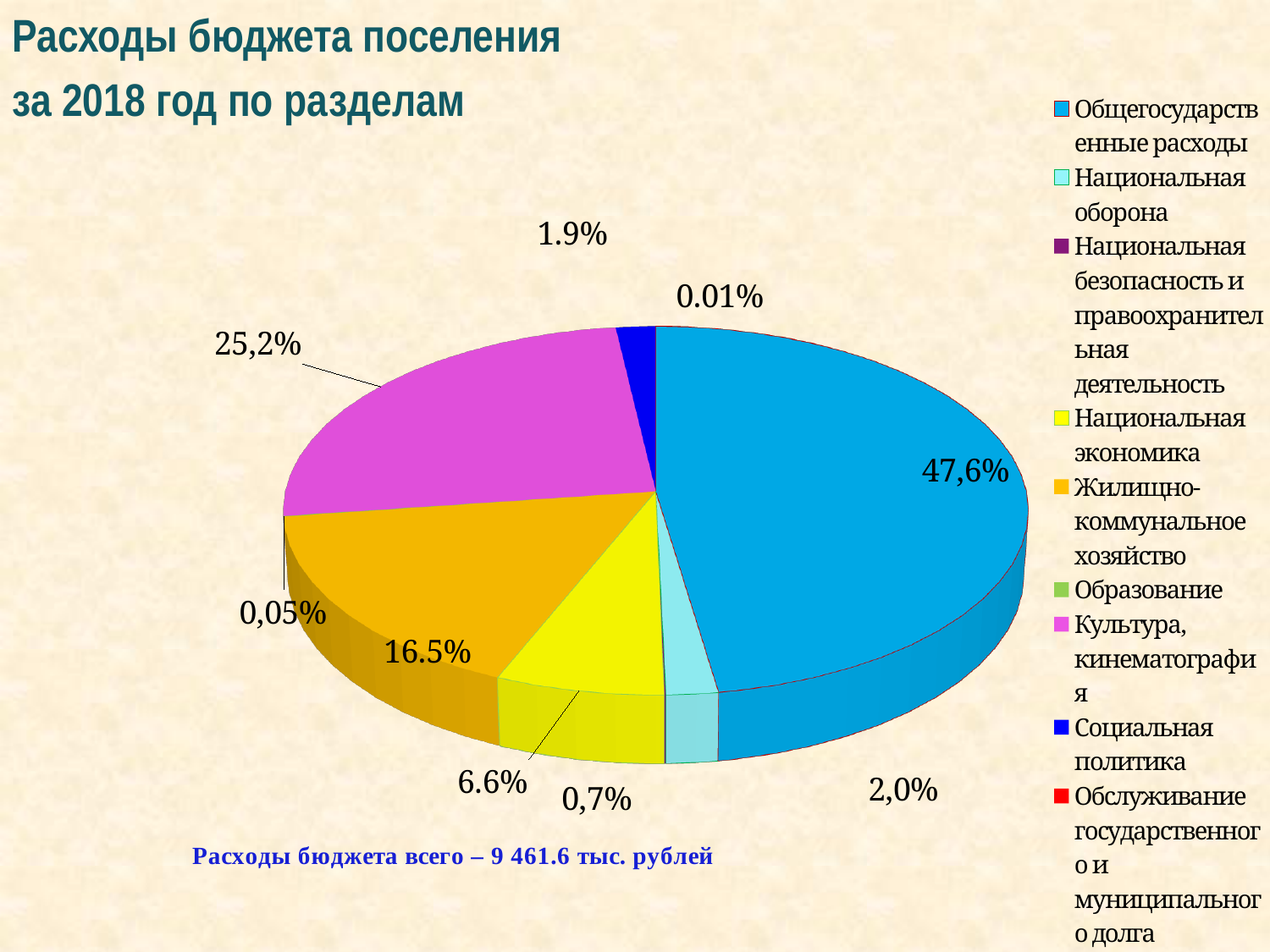
What is the difference between the share for Общегосударственные расходы and the share for Культура, кинематография? 22,4% Which is larger: the share for Культура, кинематография or the share for Жилищно-коммунальное хозяйство? Культура, кинематография What share of the pie is labelled for Общегосударственные расходы? 47,6% What kind of chart is shown on the slide? pie chart What share of the pie is labelled for Национальная экономика? 6.6% According to the text below the chart, what is the total budget expenditure? 9 461.6 тыс. рублей What share of the pie is labelled for Культура, кинематография? 25,2% Which category has the largest share of the pie? Общегосударственные расходы How many categories does the legend list? 9